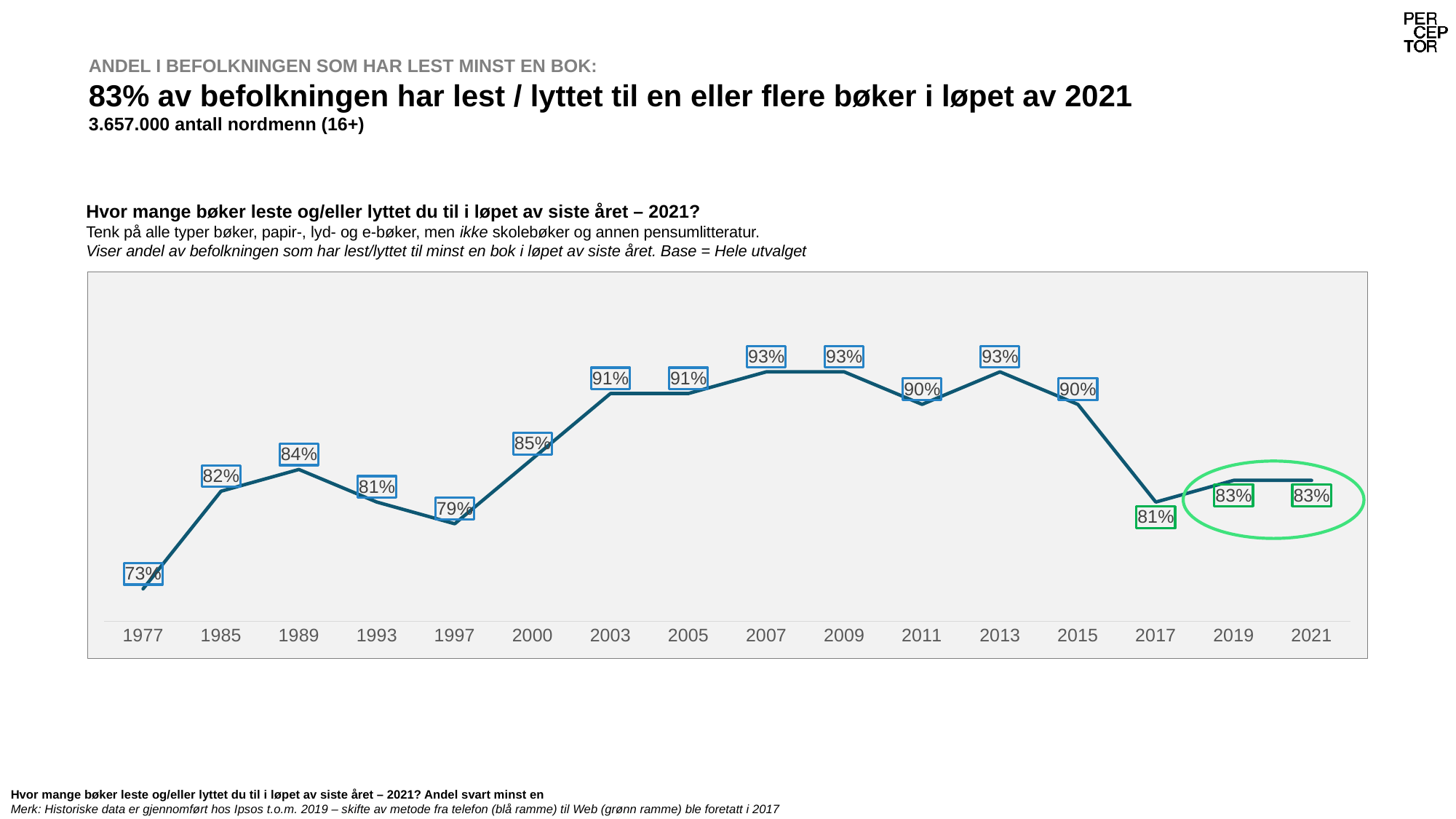
What is the value for 1977? 73% What is the value for 2017? 81% Do the values rise or fall from 1997 to 2007? rise Which is larger, the value for 1989 or the value for 1997? 1989 Which year has the lowest value? 1977 What is the value for 2021? 83% What type of chart is shown on the slide? line chart What is the value for 2000? 85% How many years are plotted on the x axis? 16 What is the difference between the values for 2015 and 2017? 9 percentage points What is the highest value shown on the chart? 93% Which two years have their data labels outlined in green and circled? 2019 and 2021